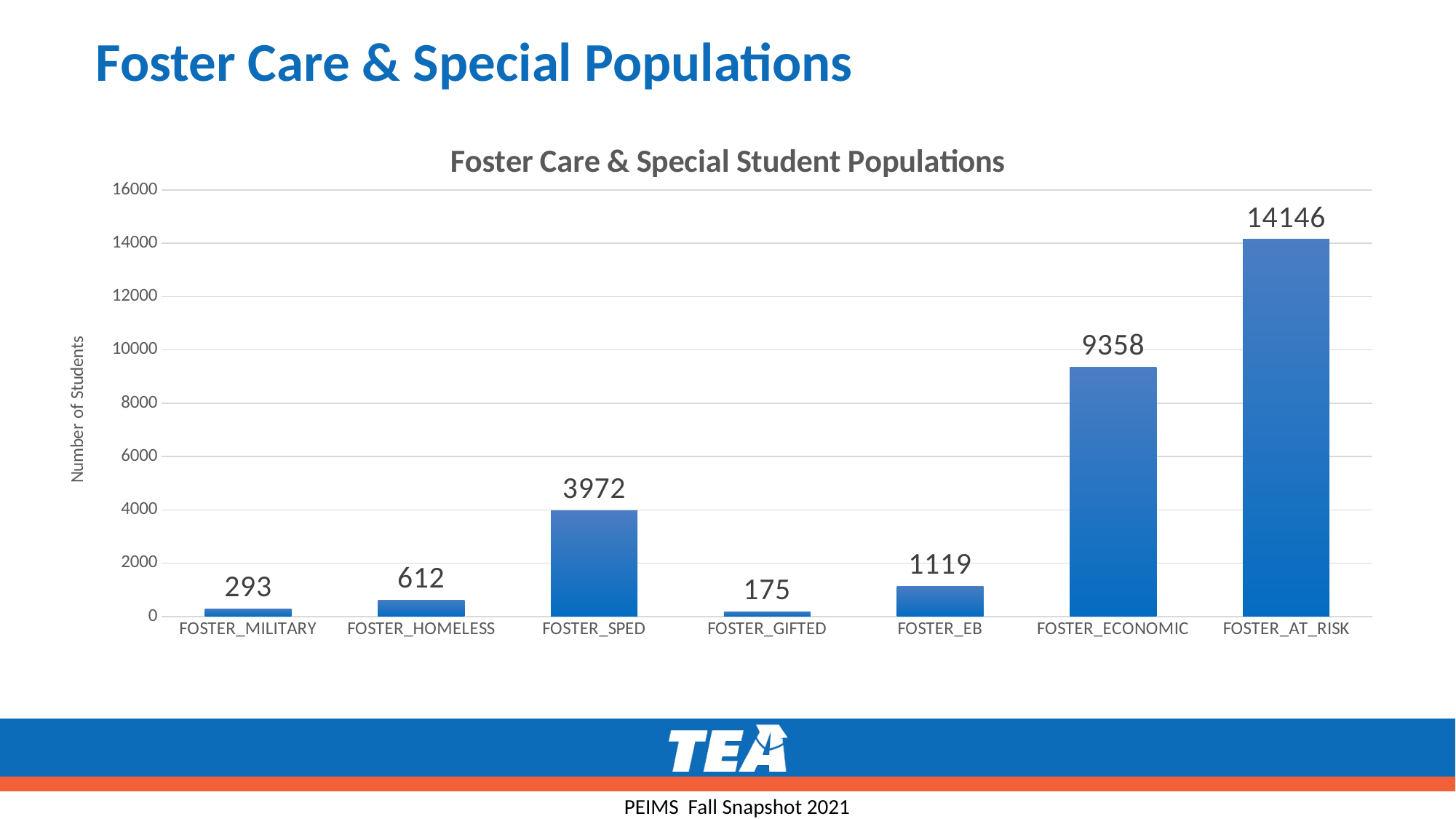
Is the value for FOSTER_SPED greater or less than 2000? greater How many categories are shown on the x axis? 7 What is the difference between FOSTER_HOMELESS and FOSTER_MILITARY? 319 What is the difference between FOSTER_AT_RISK and FOSTER_ECONOMIC? 4788 Which category has the lowest value? FOSTER_GIFTED Which is larger, FOSTER_EB or FOSTER_HOMELESS? FOSTER_EB What kind of chart is shown on the slide? bar chart What is the title of the chart? Foster Care & Special Student Populations What is the value for FOSTER_ECONOMIC? 9358 What is the value for FOSTER_GIFTED? 175 What is the value for FOSTER_SPED? 3972 Which category has the highest value? FOSTER_AT_RISK